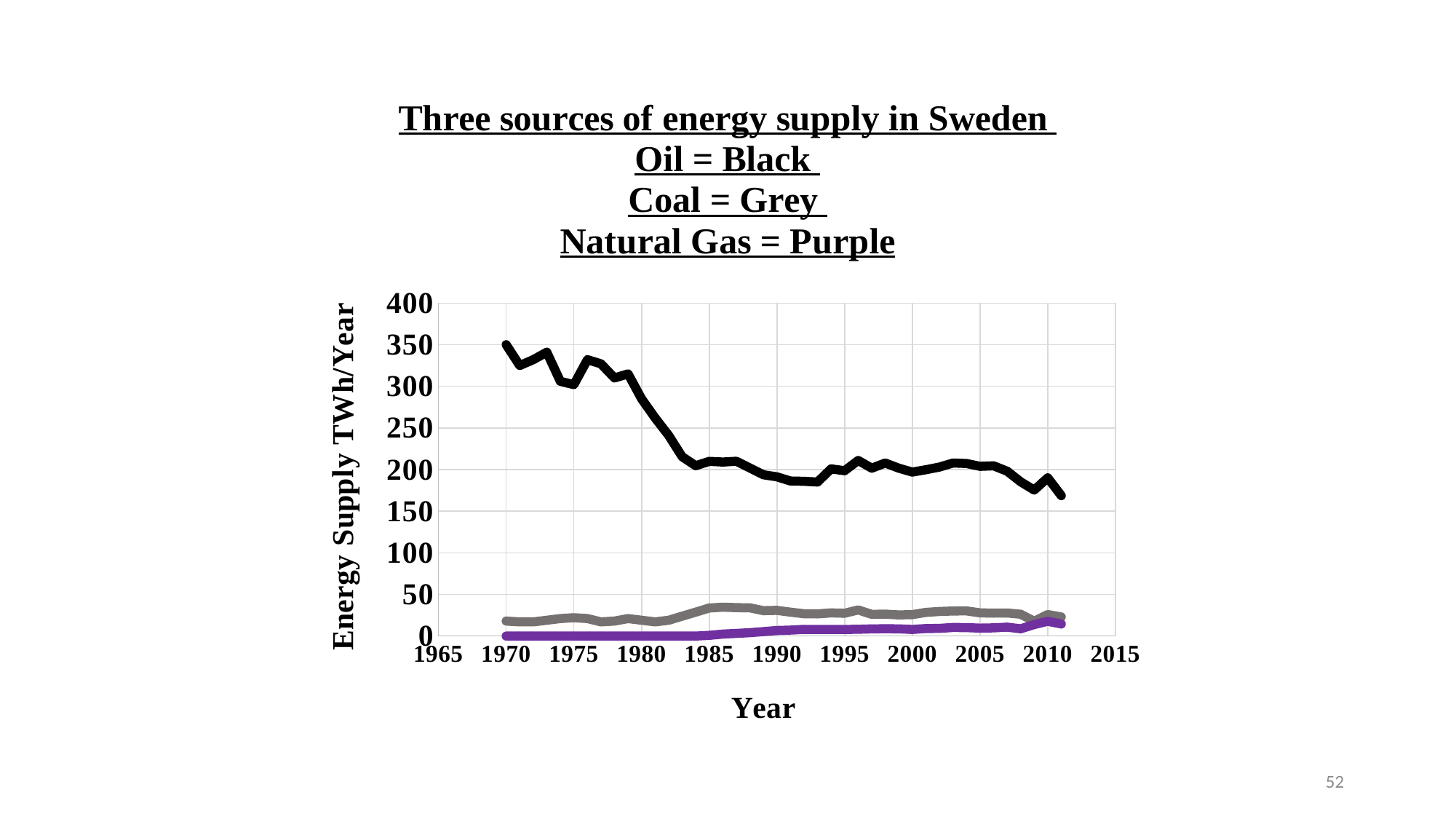
In 1980, which is larger: the coal supply or the natural gas supply? Coal What kind of chart is shown on the slide? line chart Is the oil supply in 2010 greater or less than 200 TWh/Year? less Which energy source has the highest supply throughout the period shown? Oil What colour is the line for natural gas? Purple What is the label on the vertical axis of the chart? Energy Supply TWh/Year Is the oil supply in 1970 greater or less than 300 TWh/Year? greater Is the coal supply in 1985 greater or less than 50 TWh/Year? less Does the oil supply rise or fall overall from 1970 to 2011? fall Which energy source has the lowest supply throughout the period shown? Natural Gas How many energy sources (series) are plotted on the chart? 3